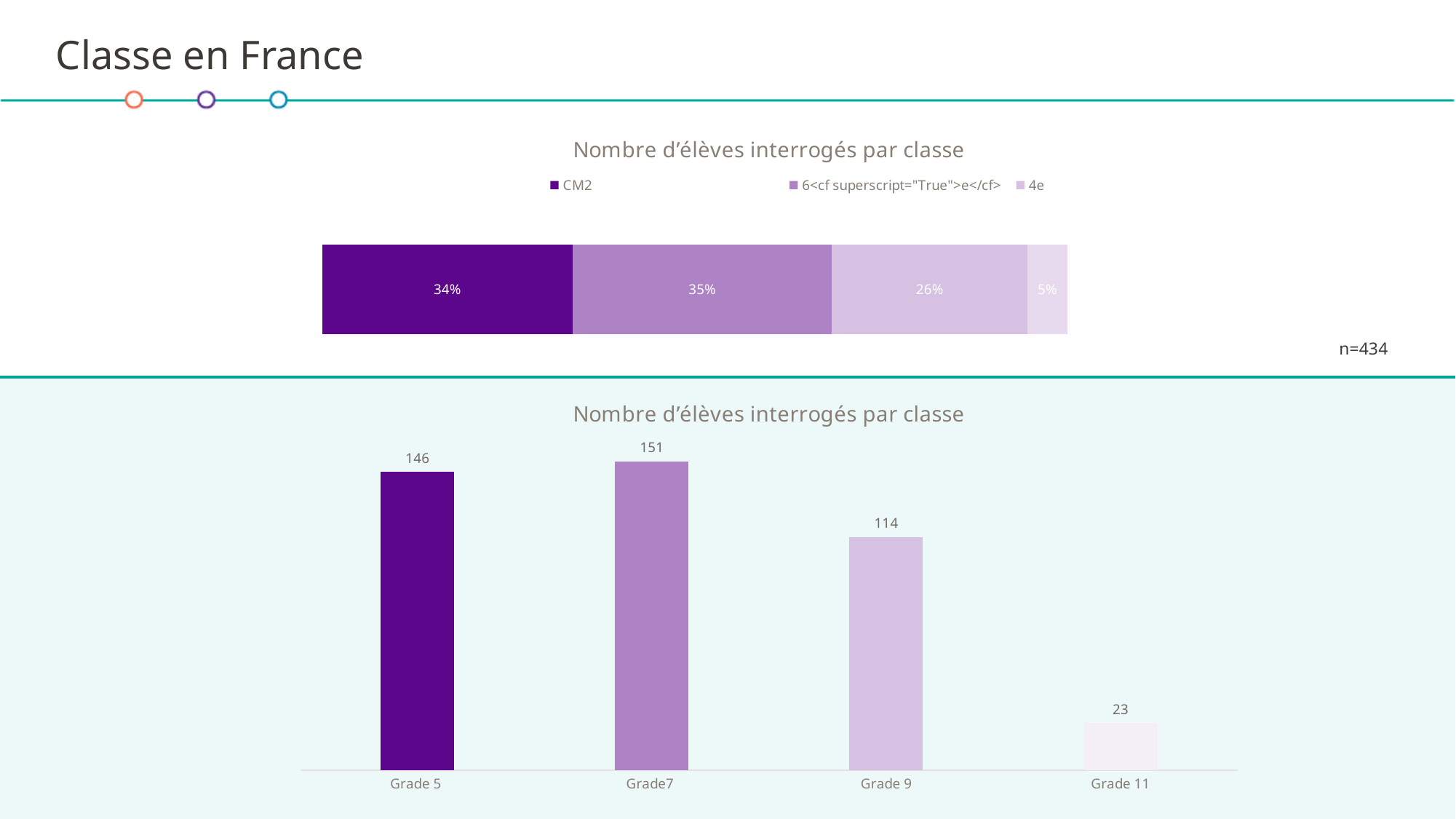
In the bottom chart, what is the value for Grade 9? 114 In the bottom chart, what is the value for Grade 11? 23 In the top chart, what percentage is shown for CM2? 34% In the top chart, what is the largest percentage shown in the stacked bar? 35% What kind of chart is the top chart? stacked bar chart In the bottom chart, which grade has the highest number of students surveyed? Grade7 How many categories are shown in the bottom chart? 4 What kind of chart is the bottom chart? bar chart In the top chart, what percentage is shown for 4e? 26% In the bottom chart, which grade has the lowest number of students surveyed? Grade 11 In the bottom chart, what is the difference between the values for Grade 5 and Grade 9? 32 In the bottom chart, which is larger, the value for Grade 5 or the value for Grade 11? Grade 5